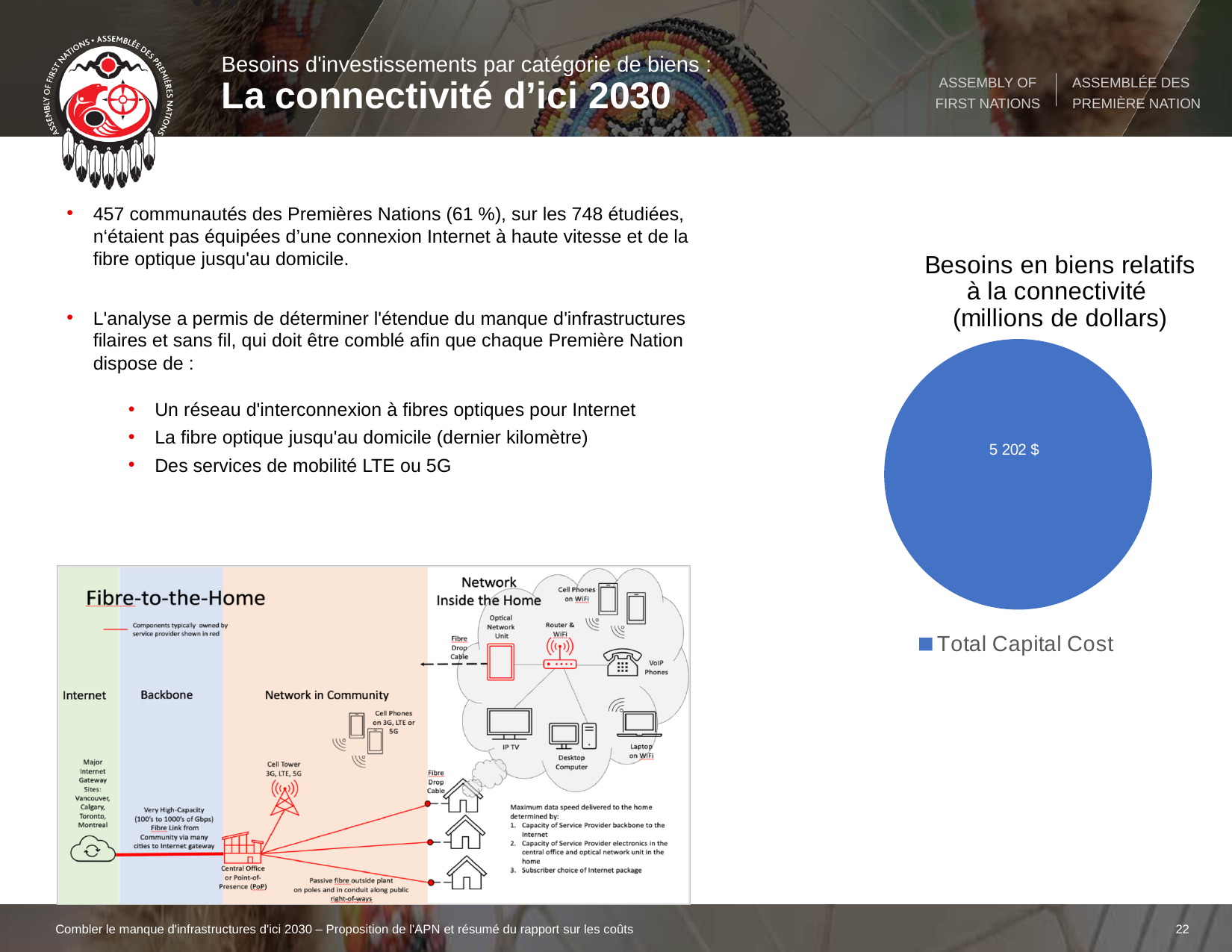
What is the legend entry shown below the pie chart "Besoins en biens relatifs à la connectivité"? Total Capital Cost What kind of chart is used to show "Besoins en biens relatifs à la connectivité"? pie chart What is the Total Capital Cost value, in millions of dollars, shown in the pie chart on the right of the slide? 5 202 $ What share of the pie chart "Besoins en biens relatifs à la connectivité" does the Total Capital Cost slice represent? 100% What is the value shown on the pie chart titled "Besoins en biens relatifs à la connectivité (millions de dollars)"? 5 202 $ How many slices does the pie chart "Besoins en biens relatifs à la connectivité" contain? 1 How many series does the legend of the pie chart "Besoins en biens relatifs à la connectivité" list? 1 In what unit are the values of the pie chart "Besoins en biens relatifs à la connectivité" expressed, according to its title? millions de dollars